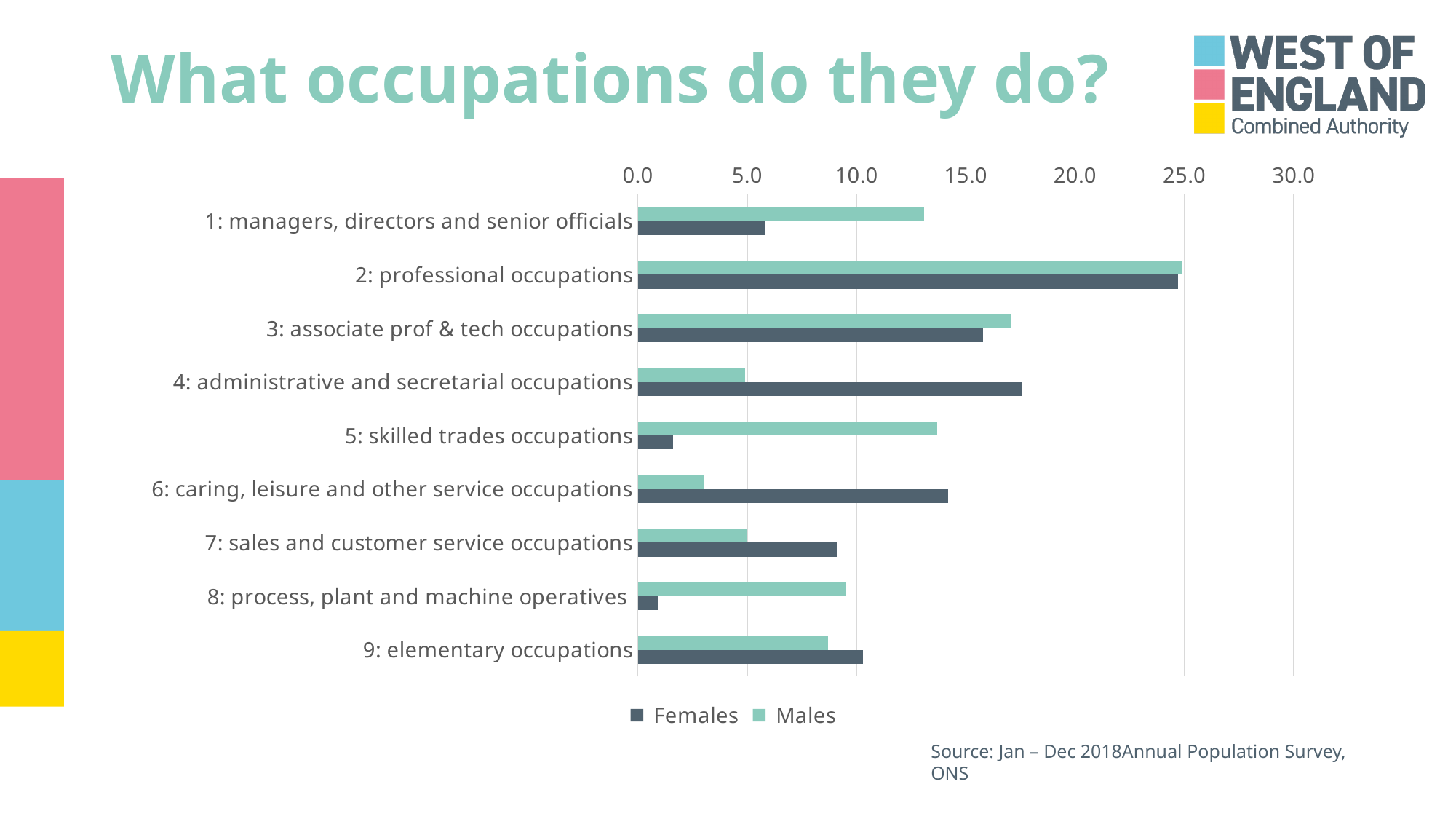
Which occupation category has the highest value for Females? 2: professional occupations How many series does the legend list? 2 Which occupation category has the lowest value for Females? 8: process, plant and machine operatives For 4: administrative and secretarial occupations, which is larger, the Females value or the Males value? Females Which colour represents the Males series in the chart? light green Which occupation category has the lowest value for Males? 6: caring, leisure and other service occupations Is the value for Males in 5: skilled trades occupations greater or less than 10.0? greater How many occupation categories are plotted on the chart? 9 For 5: skilled trades occupations, which is larger, the Females value or the Males value? Males Is the value for Males in 6: caring, leisure and other service occupations greater or less than 5.0? less Is the value for Females in 4: administrative and secretarial occupations greater or less than 15.0? greater What kind of chart is shown on the slide? bar chart